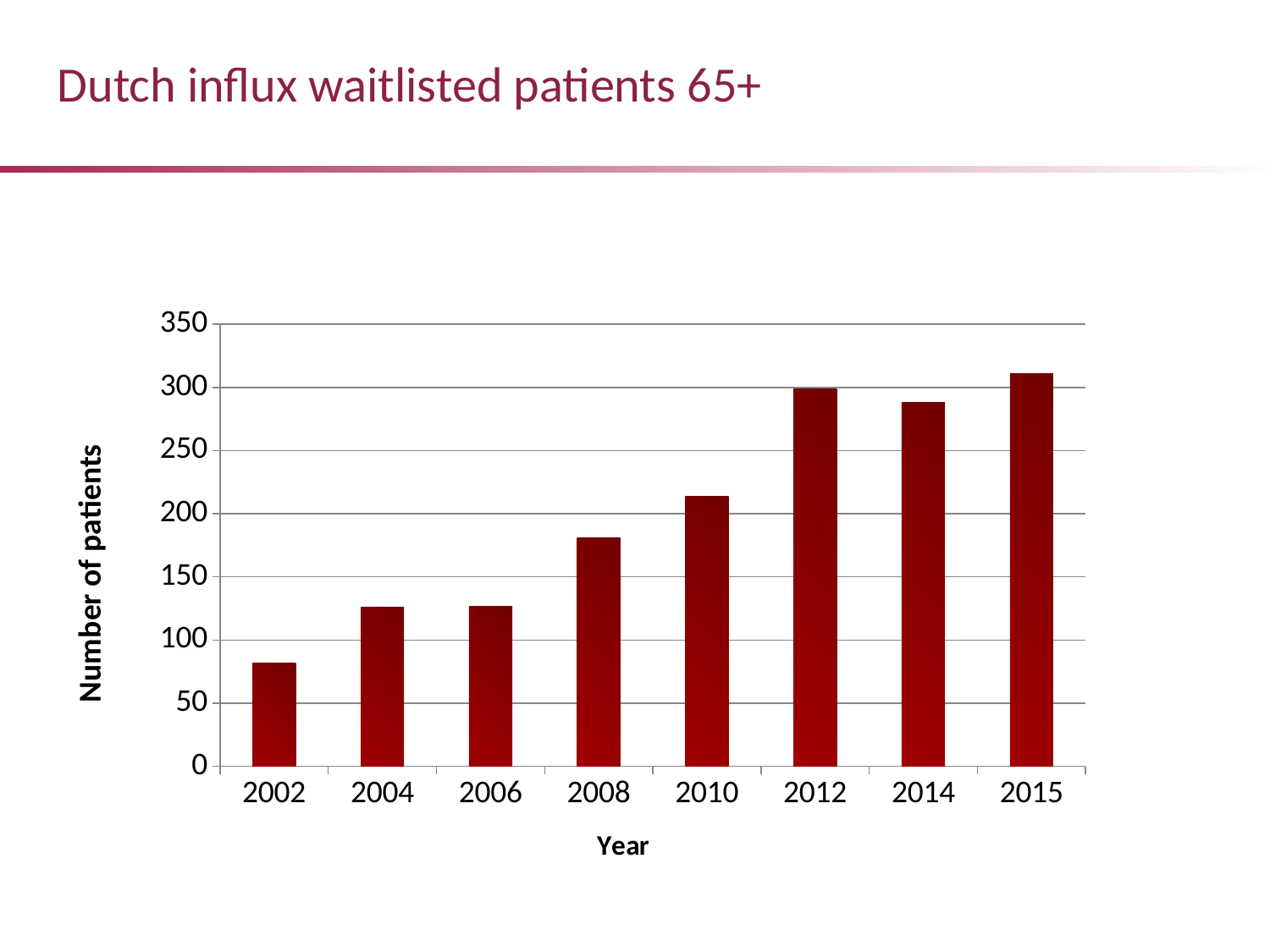
Do the values generally rise or fall from 2002 to 2015? rise What kind of chart is shown on the slide? bar chart Is the value for 2014 greater or less than 300? less Is the value for 2008 greater or less than 150? greater Is the value for 2002 greater or less than 100? less How many years are shown on the x axis of the chart? 8 Which year has the lowest number of patients? 2002 What is the label on the y axis of the chart? Number of patients Which year has the highest number of patients? 2015 Which is larger, the value for 2008 or the value for 2010? 2010